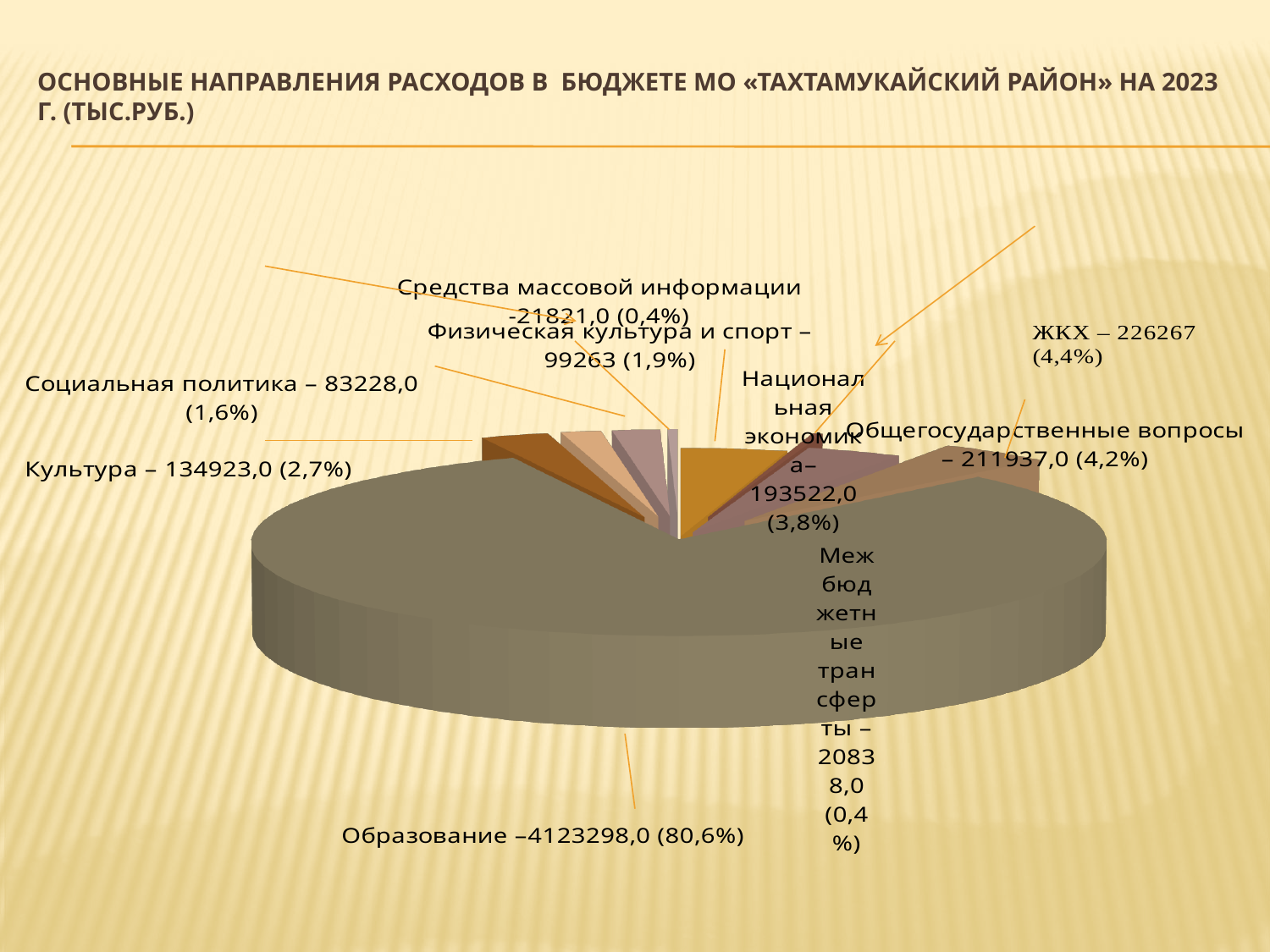
Which is larger, Культура or Социальная политика? Культура How many categories (slices) does the pie chart show? 9 What share of the pie does Образование account for? 80,6% What is the value for ЖКХ? 226267 What is the difference between the values for Культура and Социальная политика? 51695,0 Which category has the largest slice of the pie? Образование Which category has the smallest value? Межбюджетные трансферты What kind of chart is shown on the slide? pie chart What share of the pie does Национальная экономика account for? 3,8% What is the value for Образование? 4123298,0 In what units are the values in the chart expressed, according to the slide title? тыс.руб. What is the difference between the values for ЖКХ and Общегосударственные вопросы? 14330